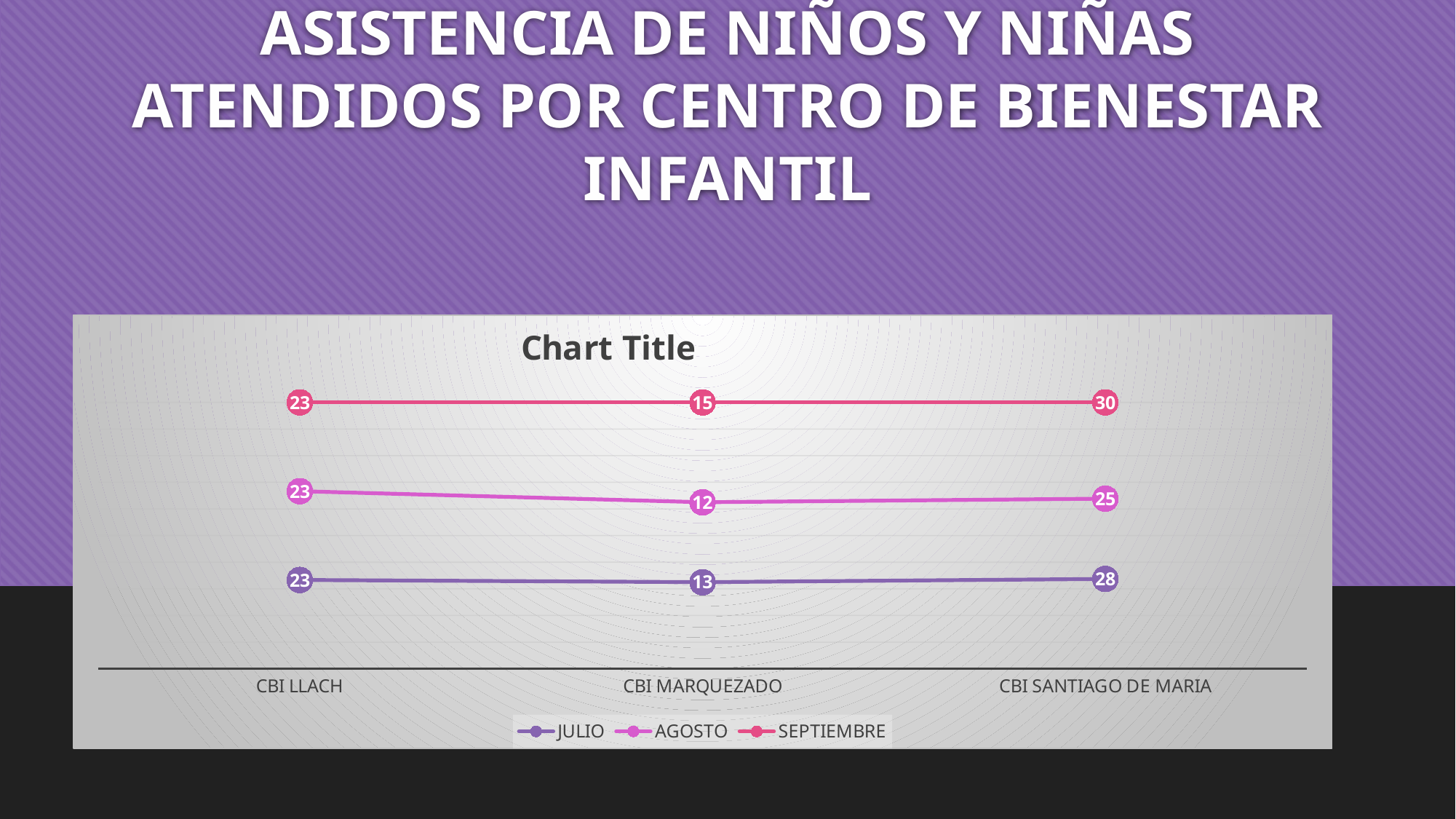
What is the difference between the JULIO values for CBI LLACH and CBI MARQUEZADO? 10 How many series does the legend list? 3 Which is larger for CBI SANTIAGO DE MARIA, the JULIO value or the AGOSTO value? JULIO What are the three series listed in the legend? JULIO, AGOSTO, SEPTIEMBRE What is the JULIO value for CBI SANTIAGO DE MARIA? 28 What kind of chart is shown on the slide? Line chart What is the AGOSTO value for CBI MARQUEZADO? 12 How many centres are shown on the x axis? 3 Which centre has the highest SEPTIEMBRE value? CBI SANTIAGO DE MARIA What is the SEPTIEMBRE value for CBI LLACH? 23 Which centre has the lowest AGOSTO value? CBI MARQUEZADO What is the difference between the SEPTIEMBRE values for CBI SANTIAGO DE MARIA and CBI MARQUEZADO? 15